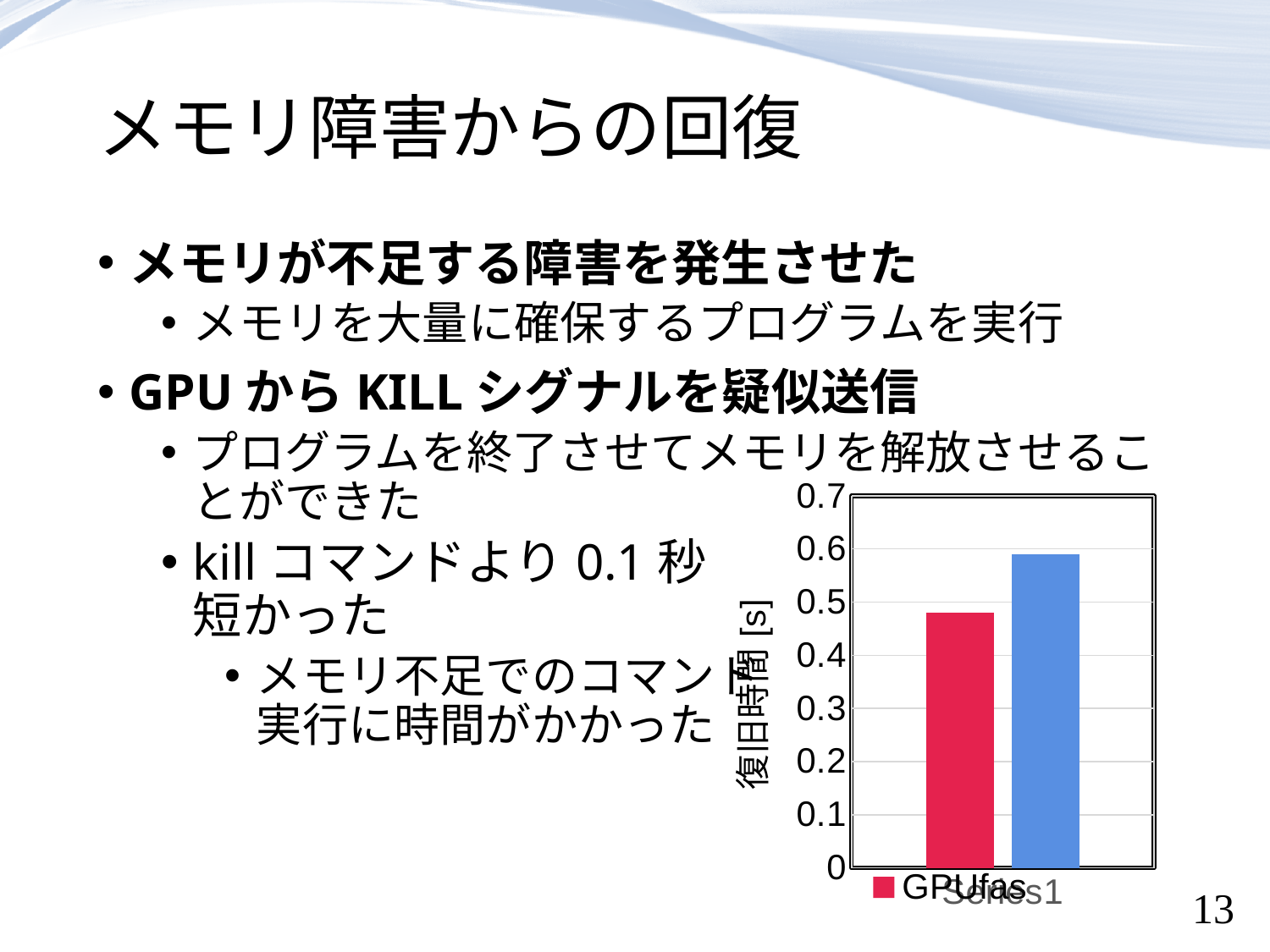
What kind of chart is shown on the slide? bar chart Which bar shows the highest value in the chart? the blue bar Do the bar values rise or fall from left to right in the chart? rise What is the highest tick value shown on the vertical axis of the chart? 0.7 How many bars are plotted in the chart? 2 Is the value of the blue bar greater or less than 0.7? less Is the value of the red bar greater or less than 0.6? less Is the value of the blue bar greater or less than 0.5? greater Which bar shows the lowest value in the chart? the red bar What is the label of the vertical axis of the chart? 復旧時間 [s] Which bar is taller in the chart, the red bar or the blue bar? the blue bar